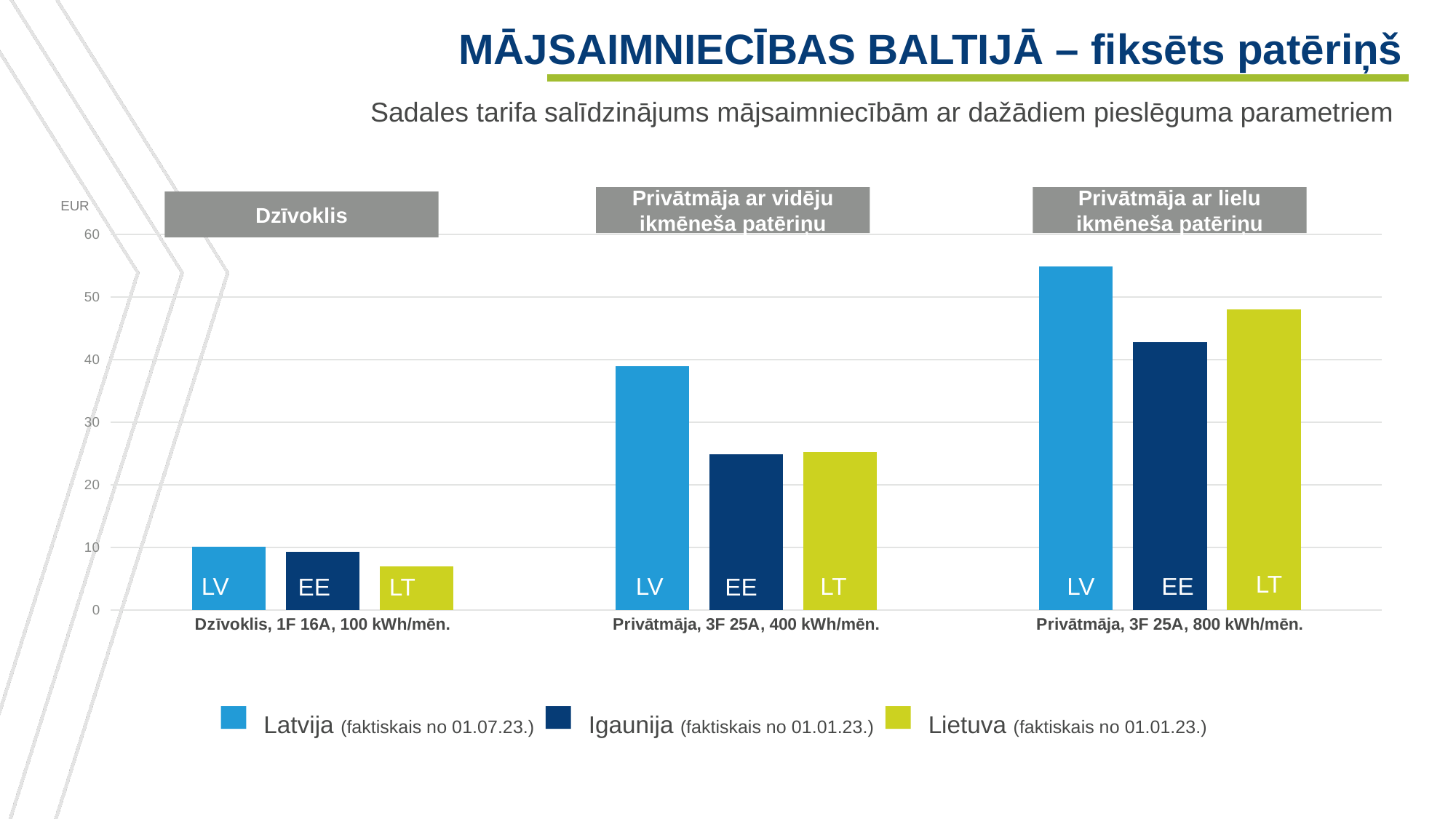
Is the value for EE in the 'Privātmāja, 3F 25A, 400 kWh/mēn.' group greater or less than 30? less Which country has the highest bar in the 'Privātmāja, 3F 25A, 400 kWh/mēn.' group? LV Which country has the lowest bar in the 'Dzīvoklis, 1F 16A, 100 kWh/mēn.' group? LT Is the value for LV in the 'Privātmāja, 3F 25A, 800 kWh/mēn.' group greater or less than 50? greater What kind of chart is shown on the slide? bar chart In the 'Privātmāja, 3F 25A, 800 kWh/mēn.' group, which is larger, the value for LT or the value for EE? LT Which country has the highest bar in the 'Privātmāja, 3F 25A, 800 kWh/mēn.' group? LV Is the value for LV in the 'Privātmāja, 3F 25A, 400 kWh/mēn.' group greater or less than 30? greater Which country has the lowest bar in the 'Privātmāja, 3F 25A, 800 kWh/mēn.' group? EE How many series does the legend list? 3 How many category groups are shown along the x axis? 3 What unit is shown on the vertical axis of the chart? EUR